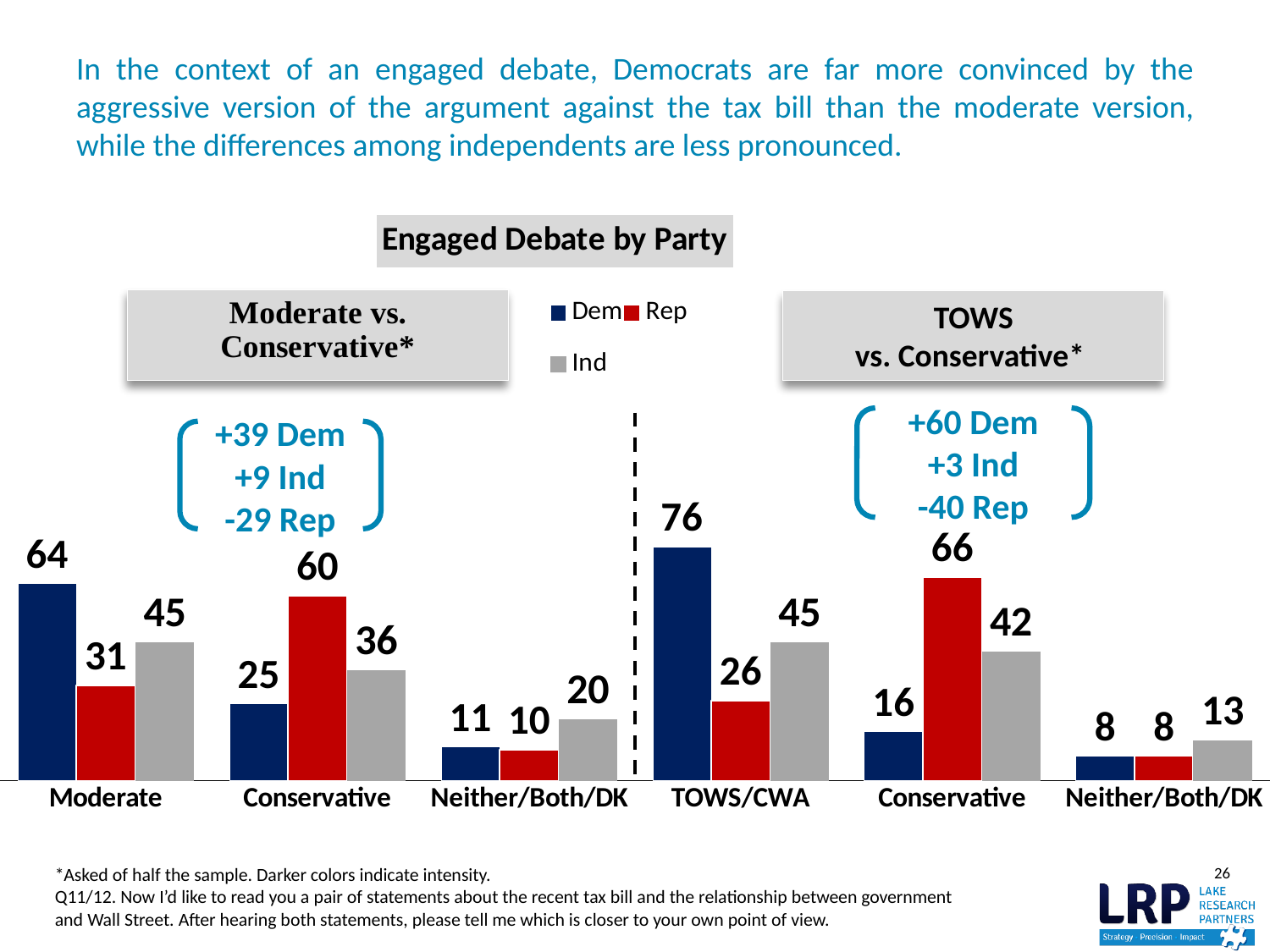
What is the Ind value for the Conservative category in the TOWS vs. Conservative half of the chart? 42 How many categories are shown along the x axis of the chart? 6 What kind of chart is shown on the slide? Bar chart What is the Dem value for the Moderate category in the Engaged Debate by Party chart? 64 What is the difference between the Dem value for TOWS/CWA and the Dem value for Moderate? 12 What is the Rep value for the TOWS/CWA category? 26 How many series does the legend list? 3 Which party has the lowest value for the Conservative category in the Moderate vs. Conservative half of the chart? Dem Which is larger: the Rep value for Conservative in the Moderate vs. Conservative half, or the Rep value for Conservative in the TOWS vs. Conservative half? TOWS vs. Conservative half (66) What is the title of the chart? Engaged Debate by Party Which party has the highest value for the TOWS/CWA category? Dem What is the difference between the Ind value and the Rep value for the Neither/Both/DK category in the Moderate vs. Conservative half? 10